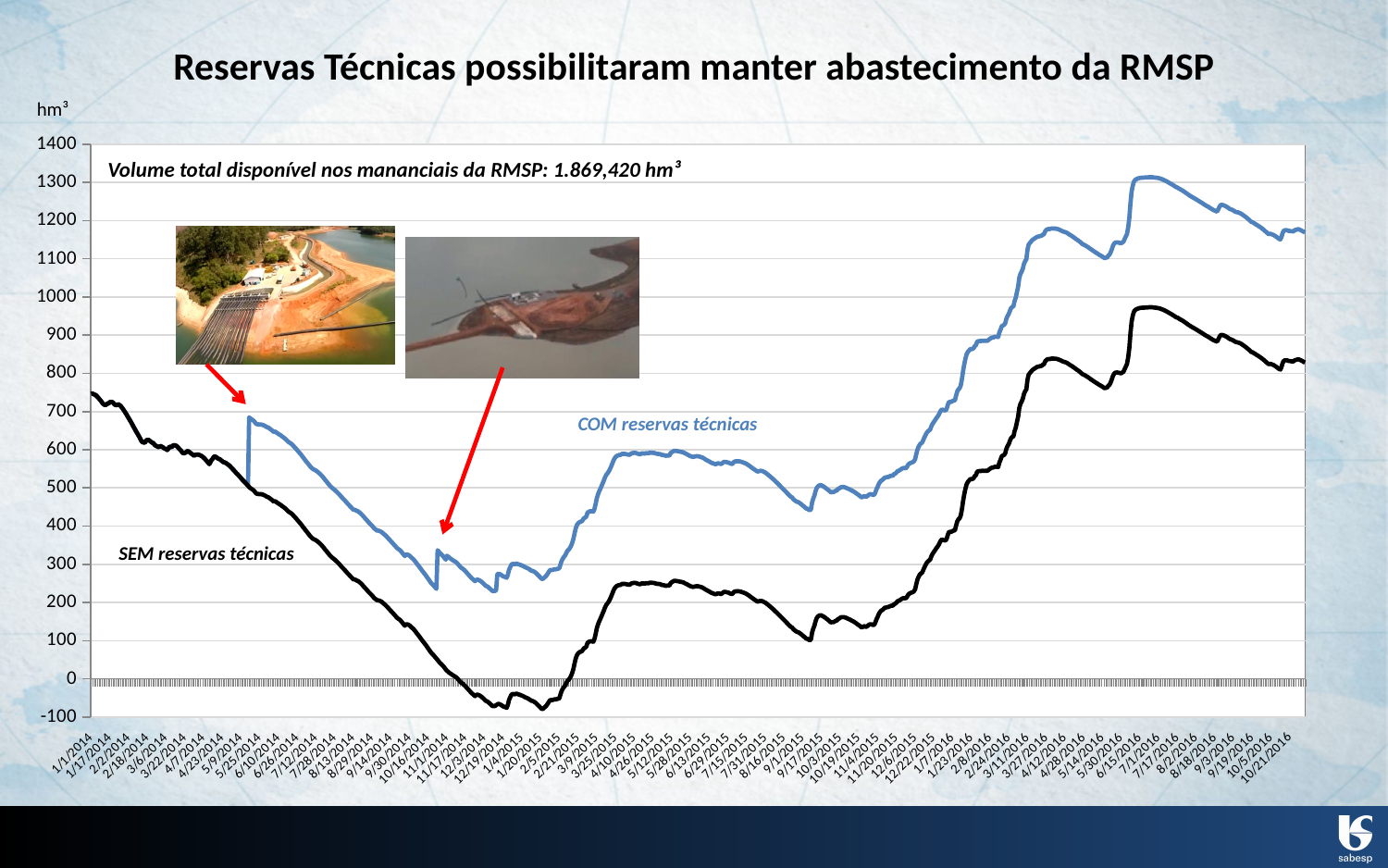
Is the lowest value of the COM reservas técnicas series greater or less than 200? greater Is the highest value of the COM reservas técnicas series greater or less than 1200? greater Is the value of the SEM reservas técnicas series at 1/1/2014 greater or less than 700? greater How many data series are plotted on the chart? 2 Do the values of the SEM reservas técnicas series rise or fall between 1/1/2014 and 11/17/2014? fall What are the names of the two series plotted on the chart? COM reservas técnicas and SEM reservas técnicas Do the values of the COM reservas técnicas series rise or fall between 12/22/2015 and 6/15/2016? rise What is the title of the slide's chart? Reservas Técnicas possibilitaram manter abastecimento da RMSP Which series is plotted higher on the chart, COM reservas técnicas or SEM reservas técnicas? COM reservas técnicas What kind of chart is shown on the slide? line chart